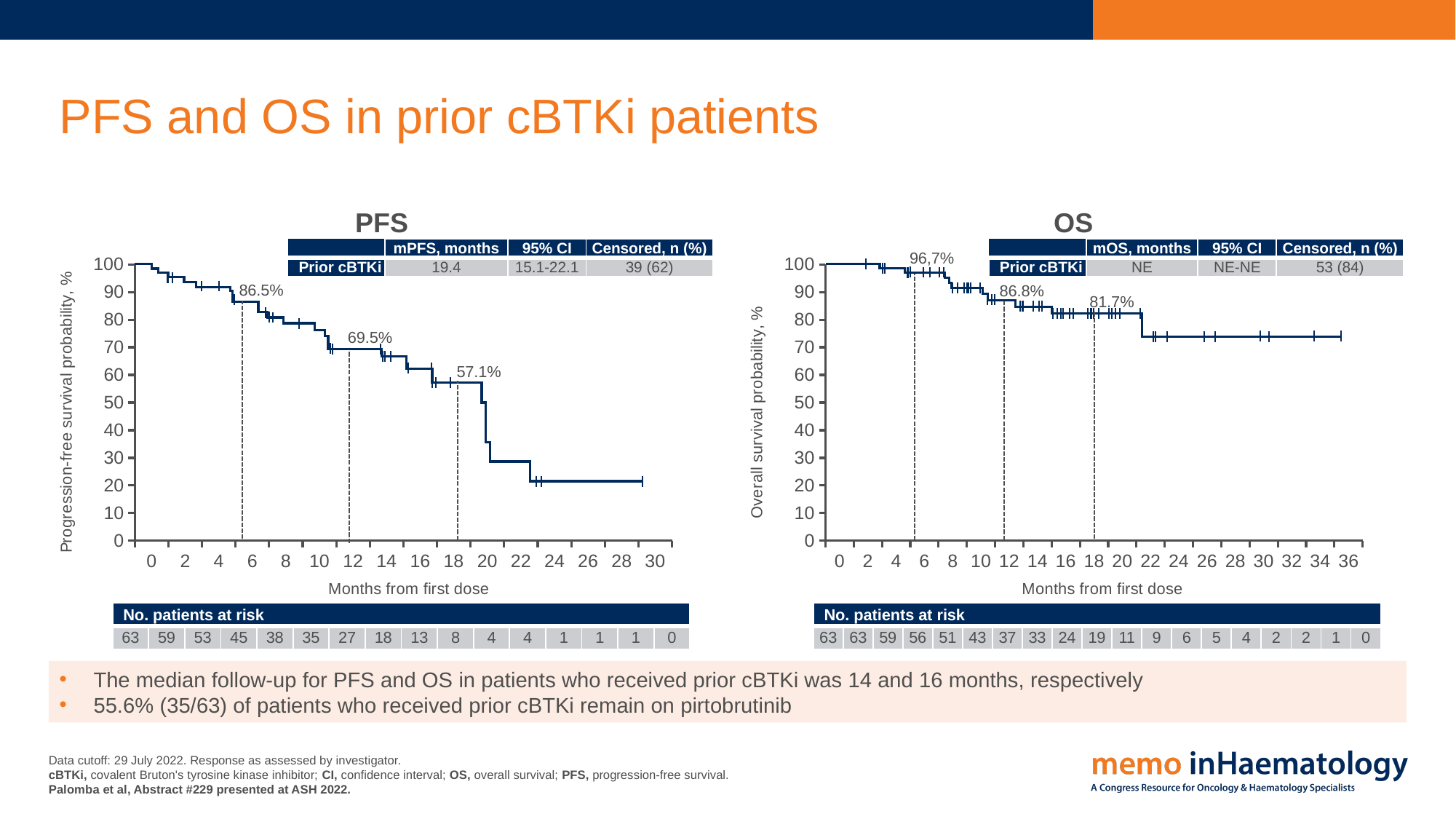
In the OS chart, what is the overall survival probability labelled at the third dashed line (around 18 months)? 81.7% In the PFS chart, what is the progression-free survival probability labelled at the second dashed line (around 12 months)? 69.5% In the PFS chart, what is the median PFS in months for prior cBTKi patients? 19.4 Do the survival curves in both charts rise or fall as months from first dose increase? fall In the PFS chart, what is the progression-free survival probability labelled at the third dashed line (around 18 months)? 57.1% In the OS chart, what is the difference between the labelled survival probabilities at the first dashed line (96.7%) and the second dashed line (86.8%)? 9.9% In the PFS chart, is the progression-free survival probability at 24 months greater or less than 30? less In the OS chart, what is the 95% CI shown for median OS? NE-NE In the PFS chart, what is the difference between the labelled probabilities 86.5% and 57.1%? 29.4% In the PFS chart, what is the progression-free survival probability labelled at the first dashed line (around 6 months)? 86.5% Which chart shows a higher labelled probability at the 18-month dashed line, PFS or OS? OS In the OS chart, how many patients are at risk at 0 months? 63